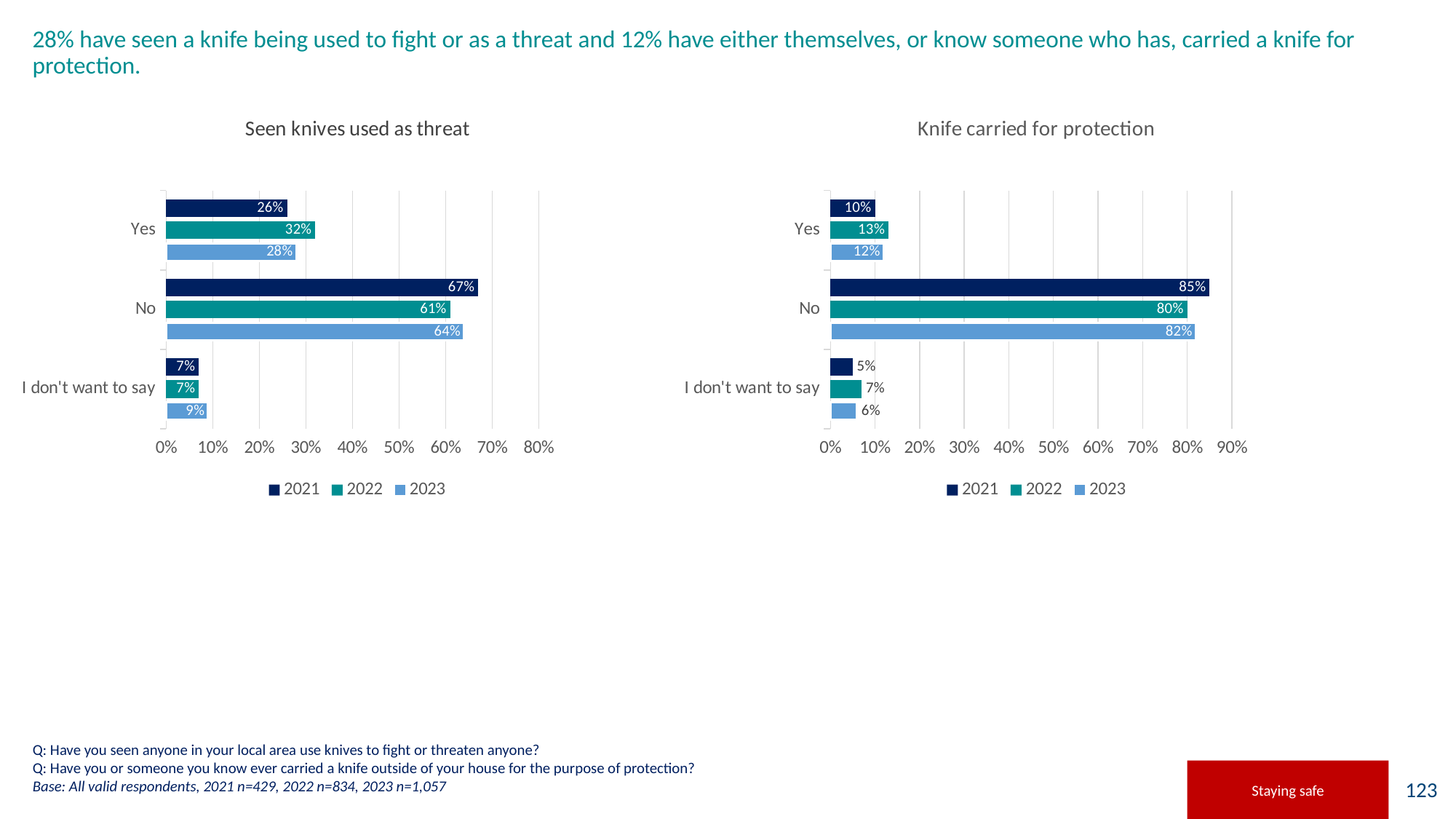
In the 'Knife carried for protection' chart, which is larger: the 2022 value for 'No' or the 2023 value for 'No'? 2023 In the 'Seen knives used as threat' chart, what is the value for 'Yes' in 2023? 28% How many categories are shown on the y axis of the 'Seen knives used as threat' chart? 3 In the 'Seen knives used as threat' chart, what is the difference between the 2021 and 2022 values for 'No'? 6 percentage points In the 'Seen knives used as threat' chart, what is the value for 'I don't want to say' in 2023? 9% In the 'Knife carried for protection' chart, what is the value for 'No' in 2021? 85% How many series does the legend of the 'Knife carried for protection' chart list? 3 What kind of chart is the 'Seen knives used as threat' chart? Bar chart What is the title of the chart on the right side of the slide? Knife carried for protection In the 'Knife carried for protection' chart, what is the value for 'Yes' in 2022? 13% In the 'Seen knives used as threat' chart, which year has the highest value for 'Yes'? 2022 In the 'Knife carried for protection' chart, which year has the lowest value for 'I don't want to say'? 2021